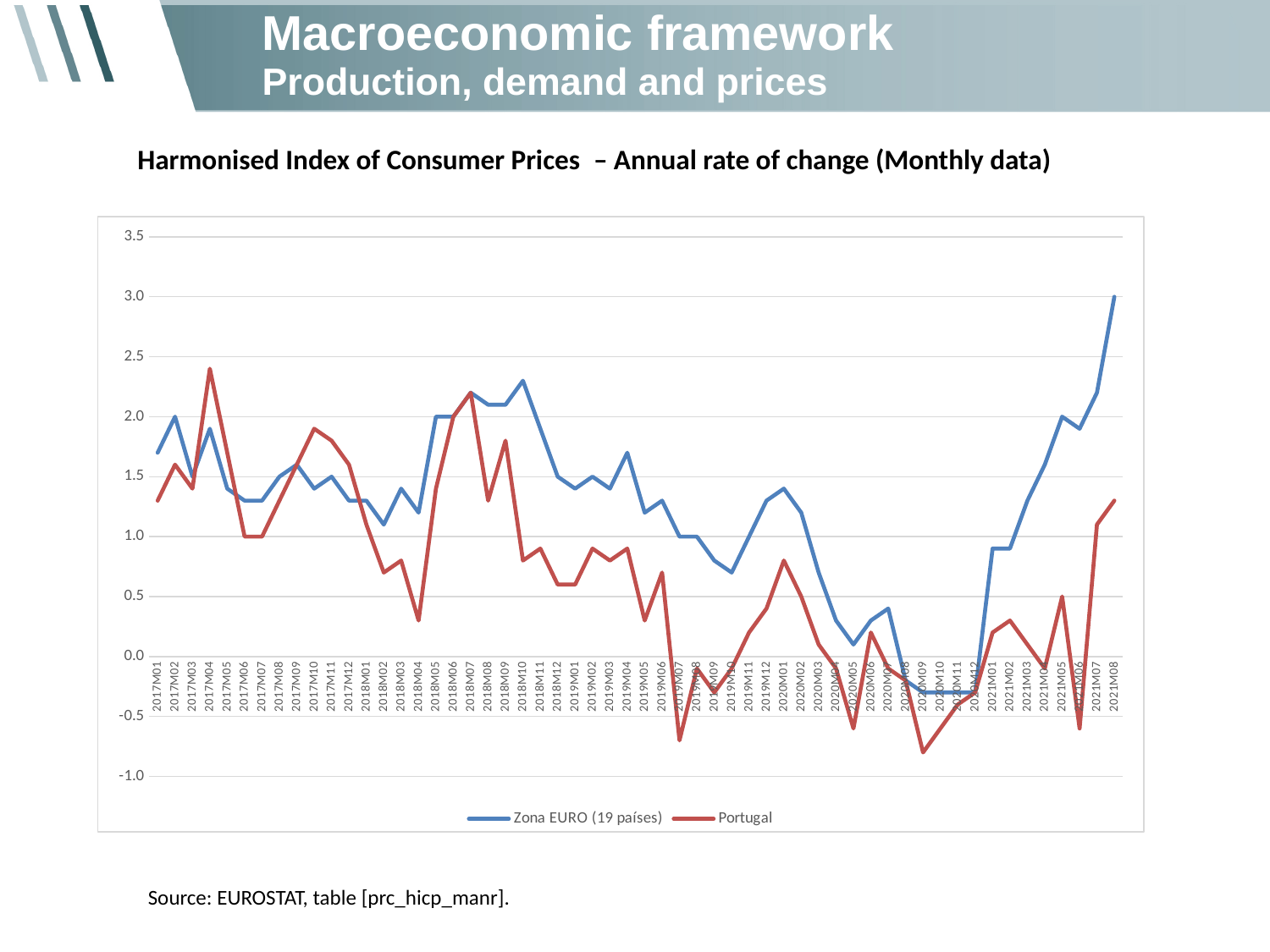
In 2017M04, which series has the higher value, Zona EURO (19 países) or Portugal? Portugal Is the value for Portugal in 2021M08 greater or less than 1.0? greater What kind of chart is shown on the slide? Line chart Is the value for Zona EURO (19 países) in 2020M05 greater or less than 0.5? less Is the value for Portugal in 2020M09 greater or less than -0.5? less In 2021M08, which series has the higher value, Zona EURO (19 países) or Portugal? Zona EURO (19 países) How many series does the legend list? 2 What is the title of the chart? Harmonised Index of Consumer Prices – Annual rate of change (Monthly data) What is the value for Zona EURO (19 países) in 2021M08? 3.0 What are the two series named in the legend? Zona EURO (19 países) and Portugal In which month does the Zona EURO (19 países) series reach its highest value? 2021M08